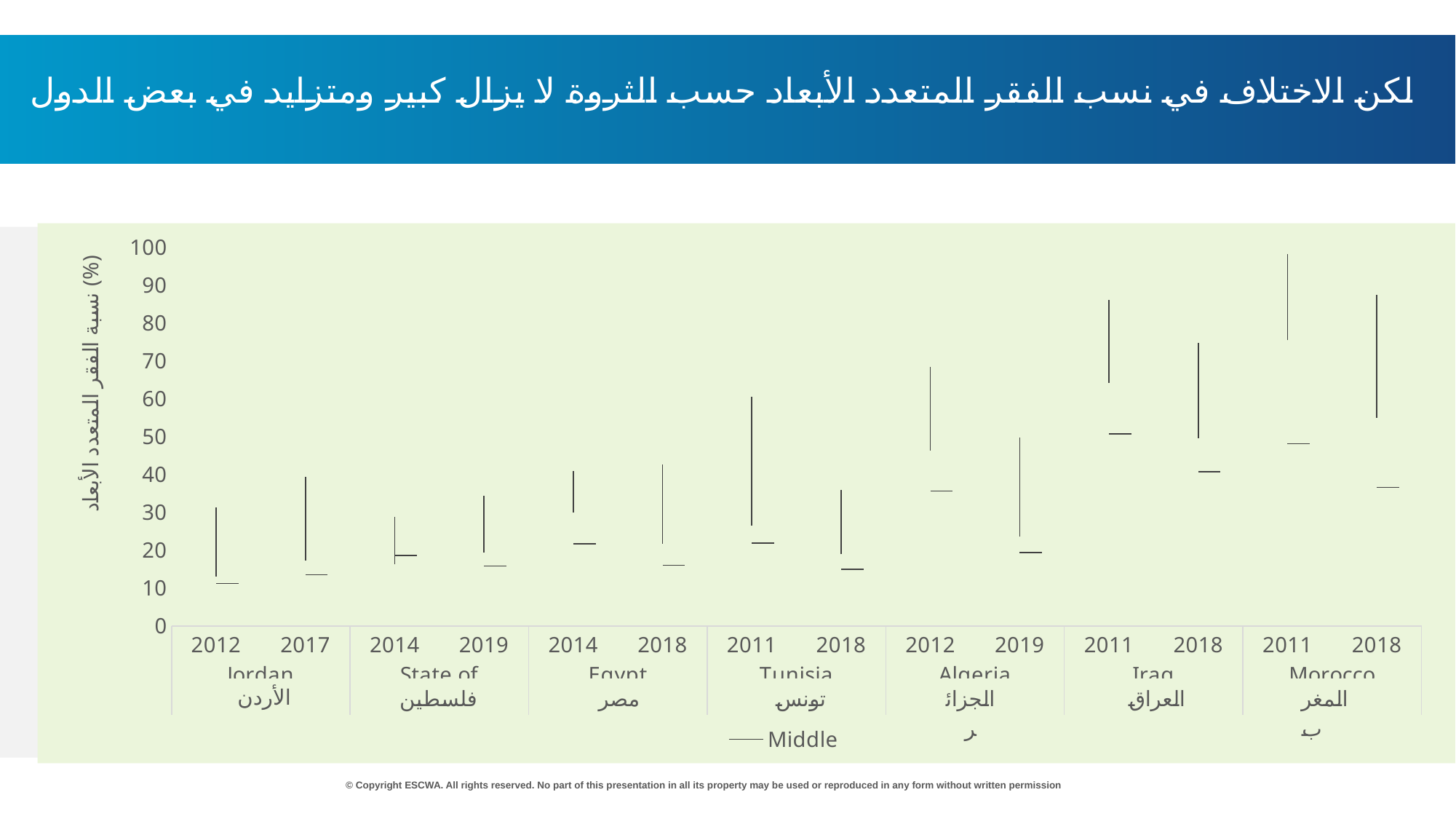
What is the name of the series shown in the legend? Middle How many series does the legend list? 1 How many countries are shown on the chart? 7 Is the Middle value for Algeria 2012 greater or less than 40? less Does the Middle value for Morocco rise or fall from 2011 to 2018? fall Is the top value for Iraq 2011 greater or less than 80? greater Is the top value for Morocco 2011 greater or less than 90? greater Which two years are shown for Jordan? 2012 and 2017 Which has the larger Middle value, Iraq 2011 or Jordan 2012? Iraq 2011 Which country-year has the highest top value on the chart? Morocco 2011